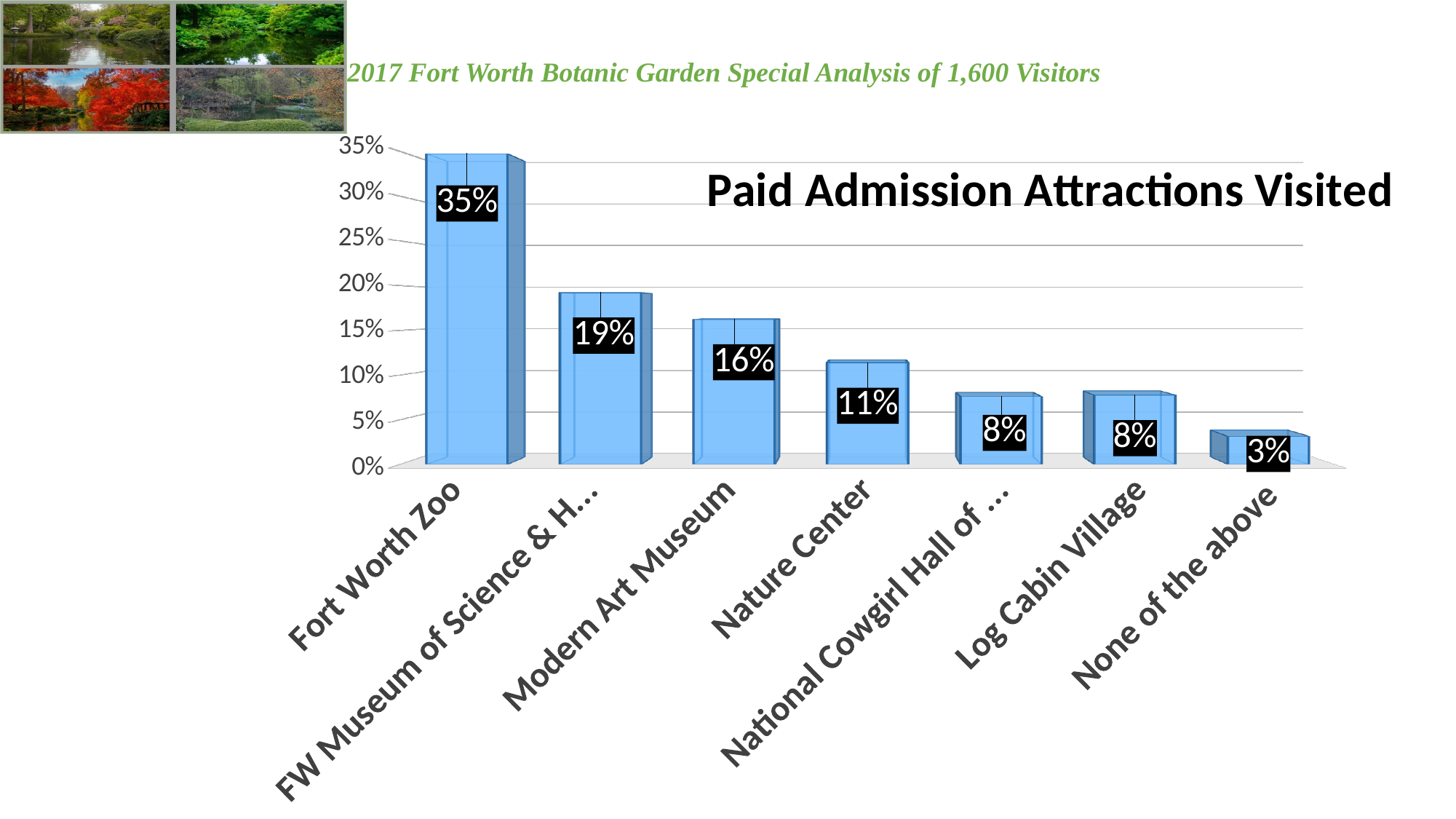
What percentage of visitors selected 'None of the above'? 3% What is the value shown for the Modern Art Museum? 16% What percentage is shown for Nature Center? 11% What is the value for Log Cabin Village? 8% Which is larger, the value for Nature Center or the value for Log Cabin Village? Nature Center What type of chart is shown on the slide? Bar chart Which attraction has the highest percentage of visitors? Fort Worth Zoo How many categories are shown on the chart? 7 Which category has the lowest value on the chart? None of the above What percentage of visitors visited the Fort Worth Zoo? 35% What is the title of the chart? Paid Admission Attractions Visited What is the difference between the Fort Worth Zoo value and the Modern Art Museum value? 19%